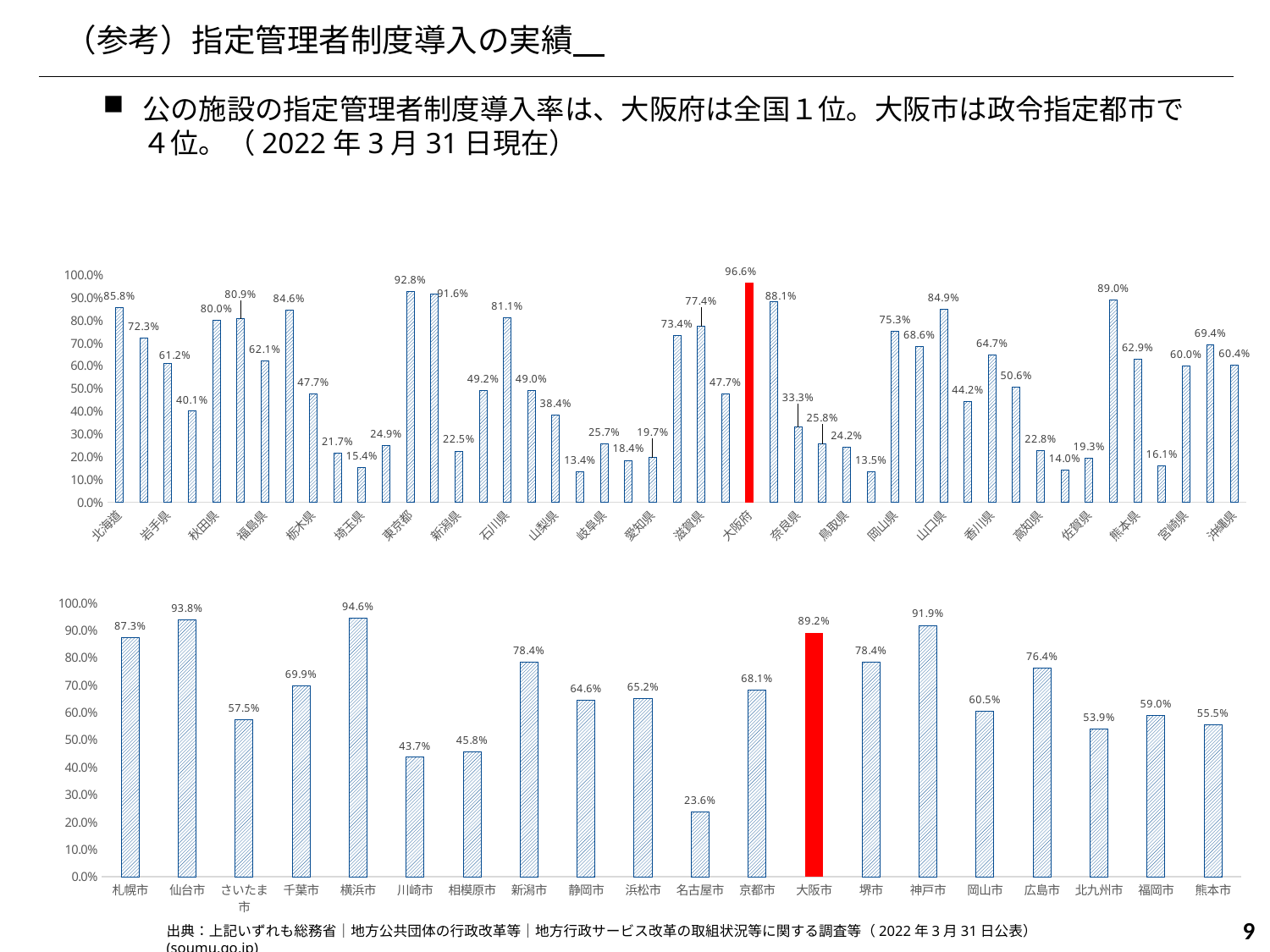
In the bottom chart (designated cities), is the value for 川崎市 greater or less than 50.0%? less In the bottom chart (designated cities), how many cities are shown? 20 In the bottom chart (designated cities), what is the value for 横浜市? 94.6% In the bottom chart (designated cities), which is larger, 神戸市 or 堺市? 神戸市 In the bottom chart (designated cities), which city has the lowest value? 名古屋市 In the bottom chart (designated cities), what is the difference between 仙台市 and 札幌市? 6.5% In the bottom chart (designated cities), what is the value for 大阪市? 89.2% In the bottom chart (designated cities), which city has the highest value? 横浜市 In the top chart (prefectures), what is the value for 北海道? 85.8% In the top chart (prefectures), what is the value for 大阪府? 96.6% In the bottom chart (designated cities), which bar is coloured solid red? 大阪市 What kind of chart is the top chart? bar chart